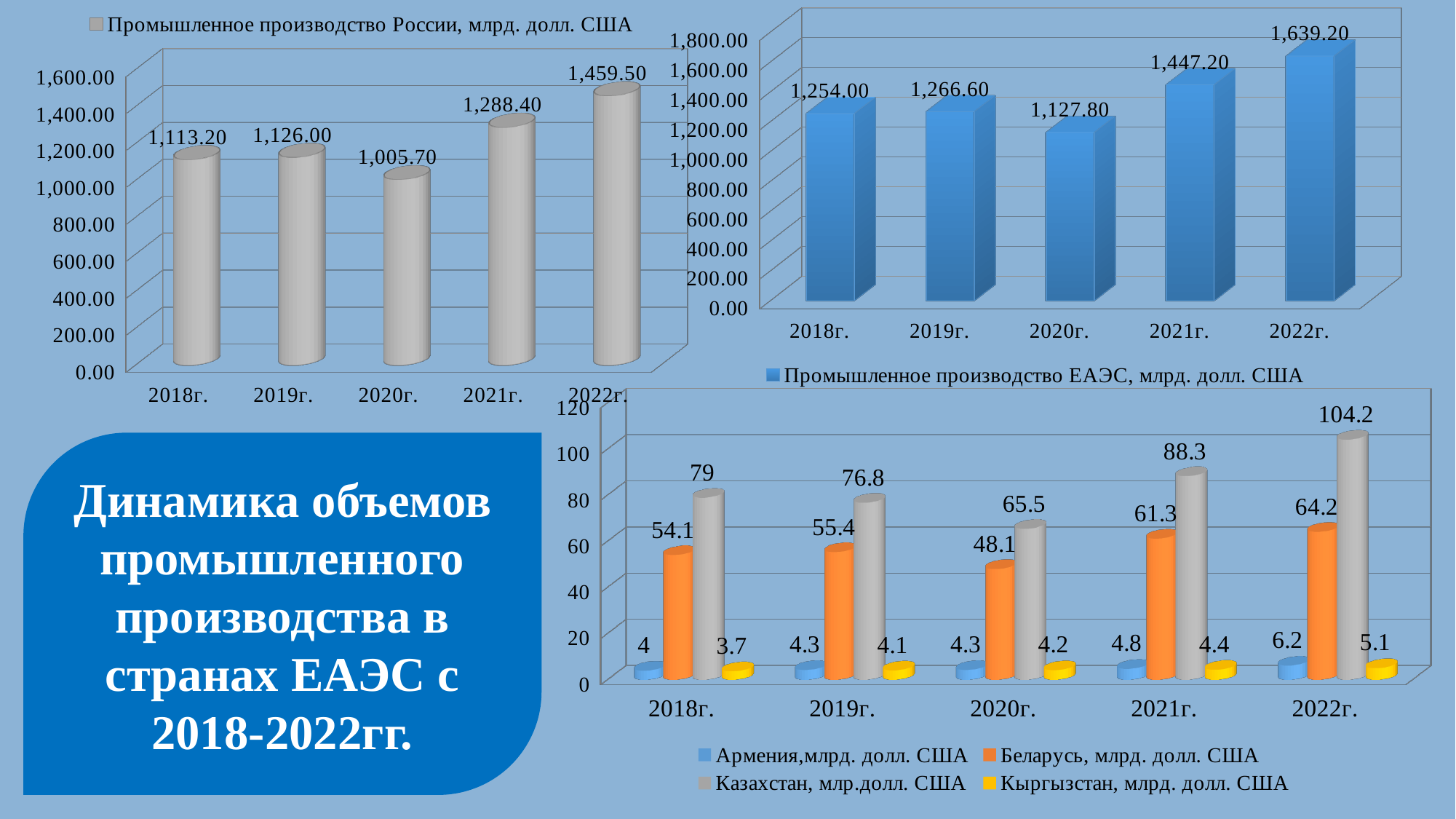
In the top-right chart (Промышленное производство ЕАЭС), how many years are shown on the x axis? 5 In the bottom-right chart, how many series does the legend list? 4 In the bottom-right chart, what is the value for Казахстан in 2021г.? 88.3 In the bottom-right chart, which is larger in 2022г.: Армения or Кыргызстан? Армения In the top-right chart (Промышленное производство ЕАЭС), which year has the lowest value? 2020г. In the bottom-right chart, what is the value for Беларусь in 2020г.? 48.1 What kind of chart is the top-left chart (Промышленное производство России)? Bar chart In the bottom-right chart, what is the difference between the Казахстан values for 2022г. and 2018г.? 25.2 In the top-left chart (Промышленное производство России), which year has the highest value? 2022г. In the top-left chart (Промышленное производство России), what is the difference between the 2022г. and 2021г. values? 171.10 In the top-right chart (Промышленное производство ЕАЭС), what is the value for 2021г.? 1,447.20 In the top-left chart (Промышленное производство России), what is the value for 2020г.? 1,005.70